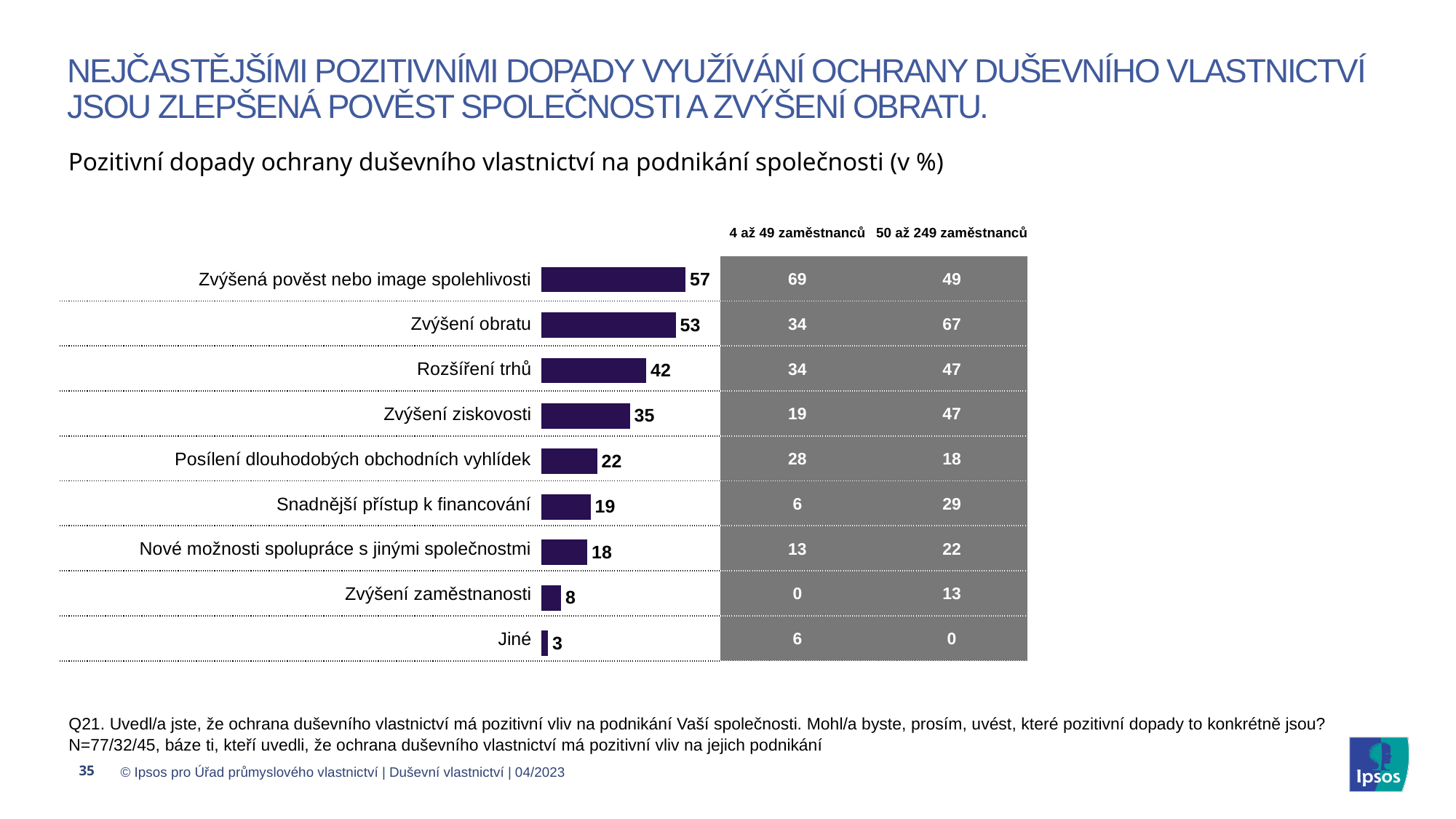
What is the value for "Rozšíření trhů" in the bar chart? 42 How many categories are shown in the bar chart? 9 In the table column "4 až 49 zaměstnanců", what is the value for "Zvýšení obratu"? 34 What kind of chart is shown on the slide? Bar chart What is the value for "Zvýšená pověst nebo image spolehlivosti" in the bar chart? 57 What is the value for "Zvýšení zaměstnanosti" in the bar chart? 8 What is the subtitle of the chart on the slide? Pozitivní dopady ochrany duševního vlastnictví na podnikání společnosti (v %) Which category has the highest value in the bar chart? Zvýšená pověst nebo image spolehlivosti In the table column "50 až 249 zaměstnanců", what is the value for "Snadnější přístup k financování"? 29 What is the difference between the values for "Zvýšená pověst nebo image spolehlivosti" and "Zvýšení obratu" in the bar chart? 4 Which category has the lowest value in the bar chart? Jiné Which is larger in the bar chart: "Zvýšení ziskovosti" or "Posílení dlouhodobých obchodních vyhlídek"? Zvýšení ziskovosti